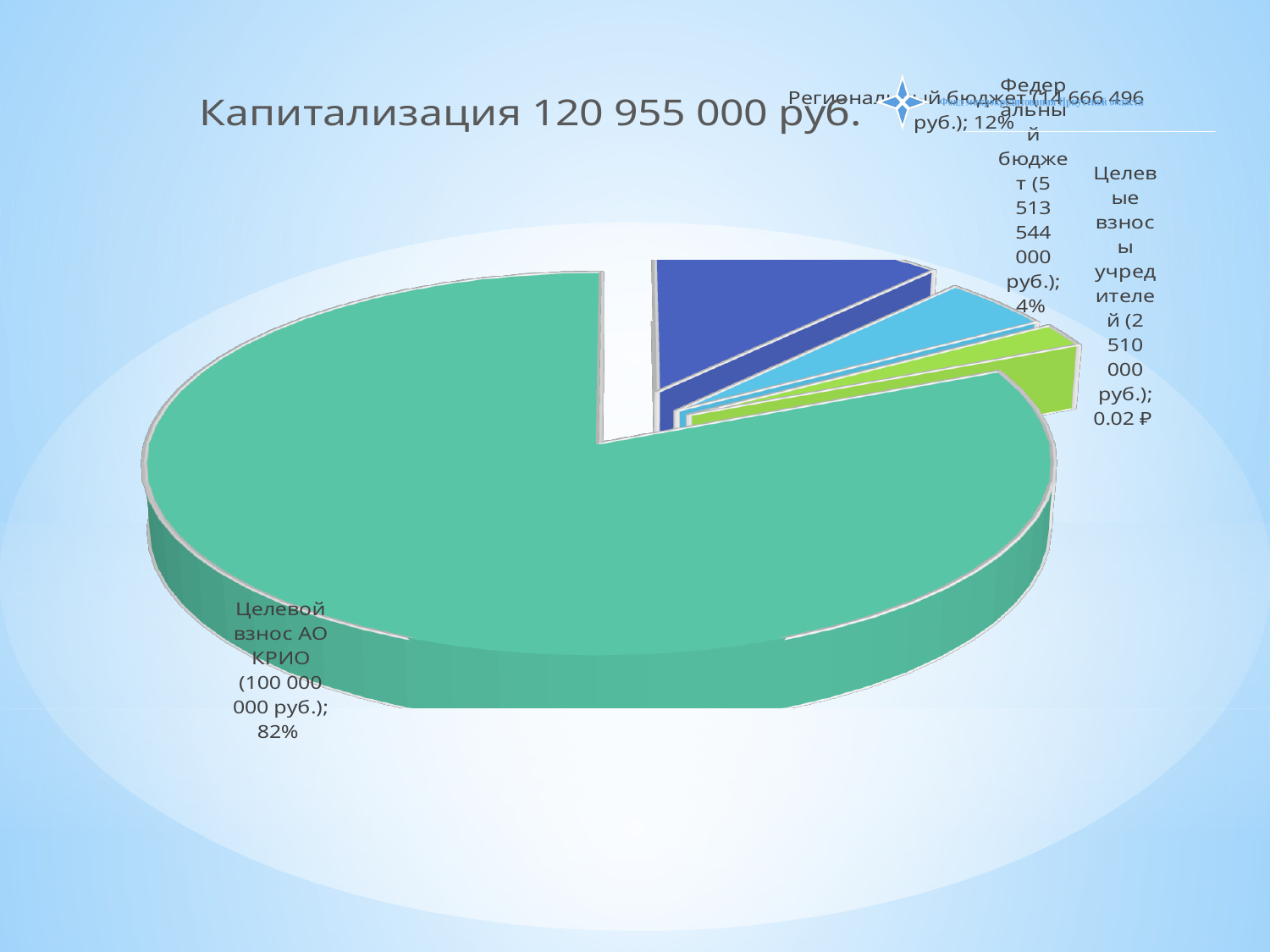
What percentage share is shown for Целевой взнос АО КРИО? 82% What amount in rubles is shown for Целевые взносы учредителей? 2 510 000 руб. What percentage share is shown for Федеральный бюджет? 4% How many slices does the pie chart have? 4 What is the title of the chart? Капитализация 120 955 000 руб. What amount in rubles is shown for Целевой взнос АО КРИО? 100 000 000 руб. Which slice is the smallest in the pie chart? Целевые взносы учредителей What amount in rubles is shown for Региональный бюджет? 14 666 496 руб. What percentage share is shown for Региональный бюджет? 12% Which slice is the largest in the pie chart? Целевой взнос АО КРИО What kind of chart is shown on the slide? Pie chart By how many percentage points does the share of Целевой взнос АО КРИО exceed the share of Региональный бюджет? 70